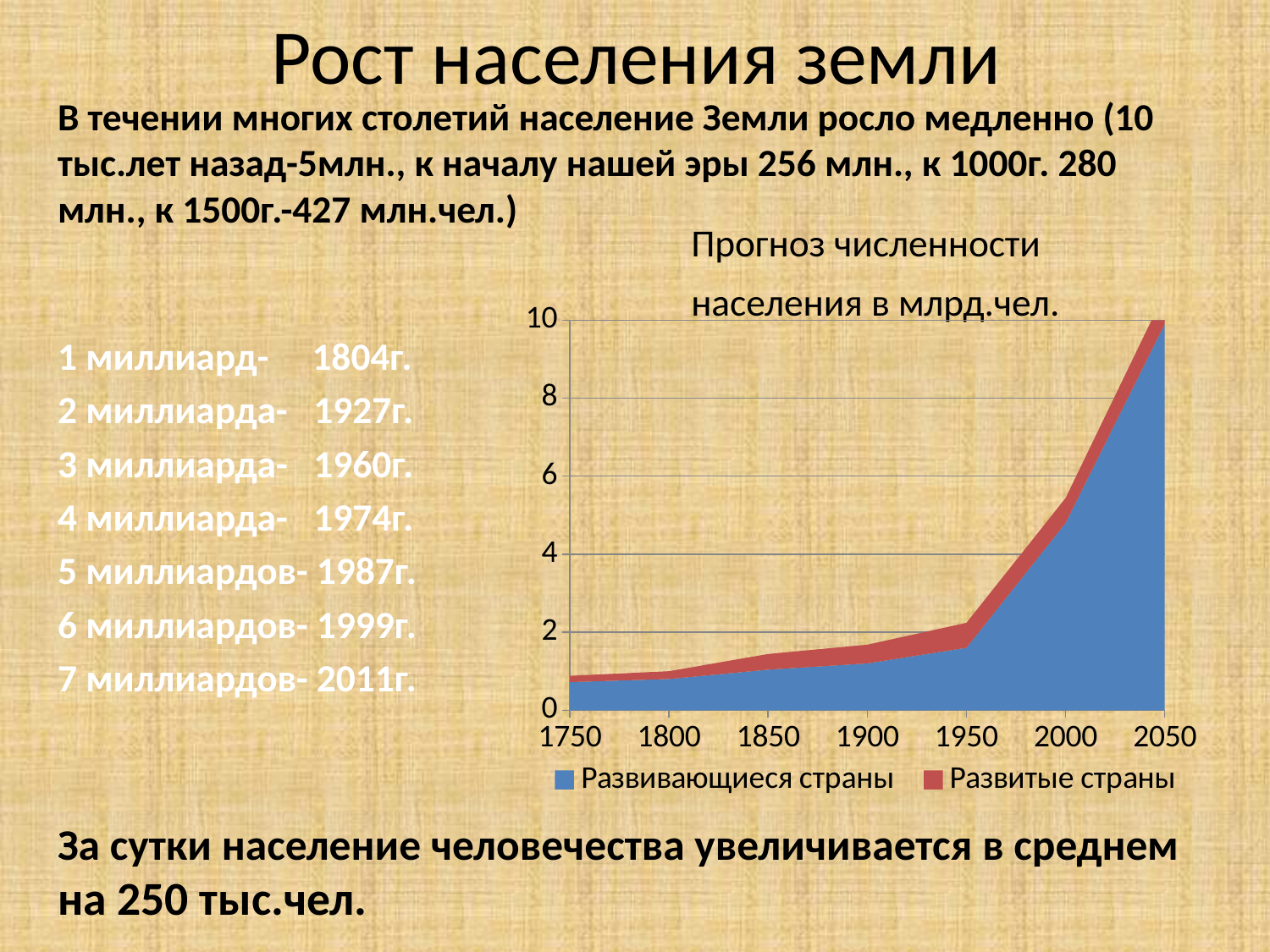
In which year is the total population shown on the chart lowest? 1750 What kind of chart is shown on the slide? area chart Is the value for Развивающиеся страны in 2000 greater or less than 4? greater What colour represents Развитые страны in the chart? red How many series does the chart legend list? 2 Which year has the larger total population on the chart, 2000 or 2050? 2050 How many years are labelled on the x axis of the chart? 7 Is the total population value for 1950 greater or less than 4? less Is the total population value for 1750 greater or less than 2? less In which year is the total population shown on the chart highest? 2050 Do the plotted population values rise or fall from 1750 to 2050? rise